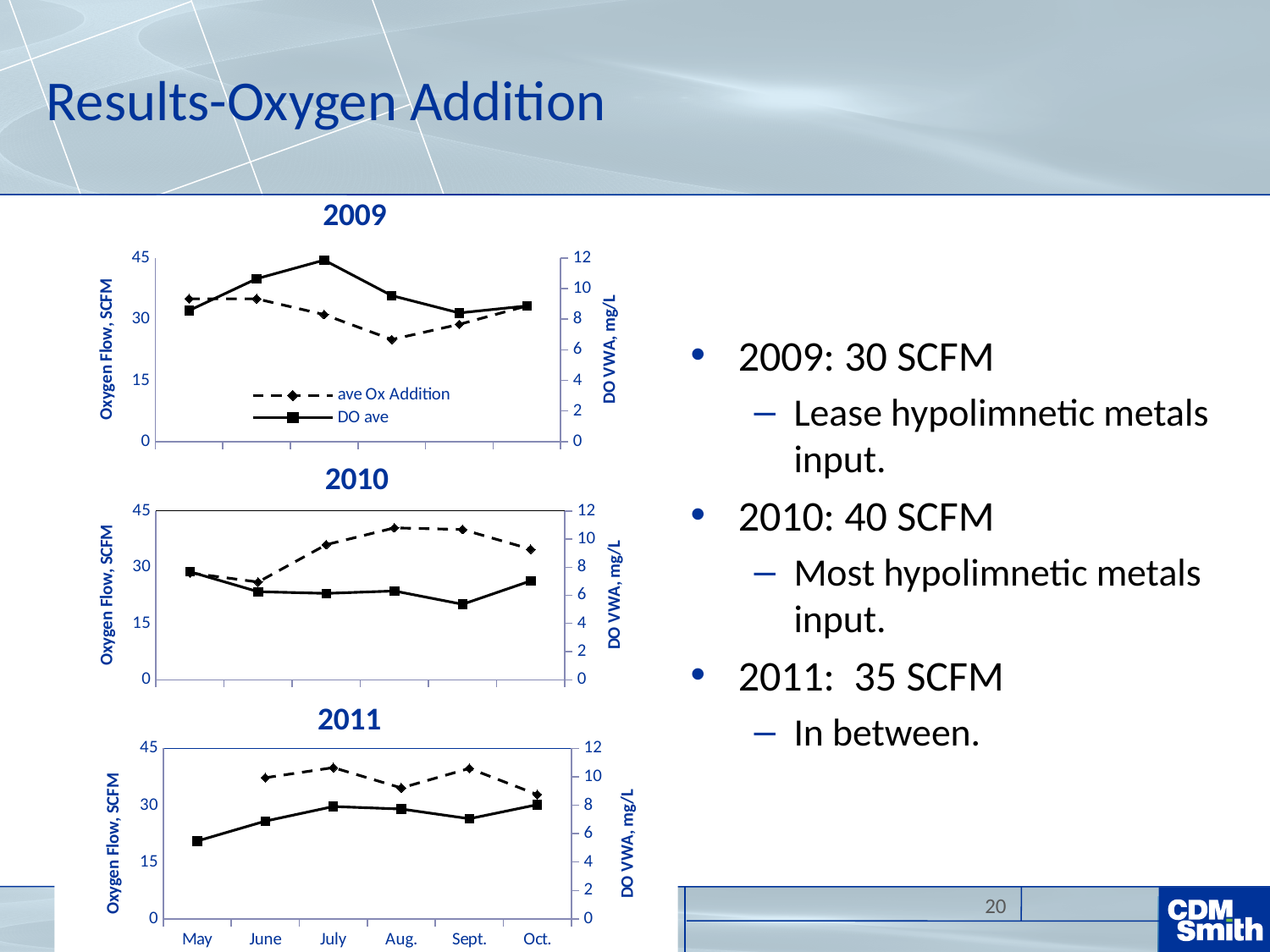
On the 2011 chart, how many months are labelled on the x axis? 6 What is the label of the right-hand vertical axis on the 2010 chart? DO VWA, mg/L On the 2009 chart, in which month is DO ave highest? July How many series does the legend on the 2009 chart list? 2 On the 2010 chart, which is larger, the ave Ox Addition value for May or for Aug.? Aug. On the 2009 chart, in which month is ave Ox Addition lowest? Aug. On the 2009 chart, is the DO ave value for July greater or less than 10? greater On the 2011 chart, in which month is DO ave lowest? May What kind of chart is the 2009 chart? line chart On the 2009 chart, is the ave Ox Addition value for Aug. greater or less than 30? less On the 2011 chart, does DO ave rise or fall from May to July? rise On the 2010 chart, is the ave Ox Addition value for Aug. greater or less than 30? greater